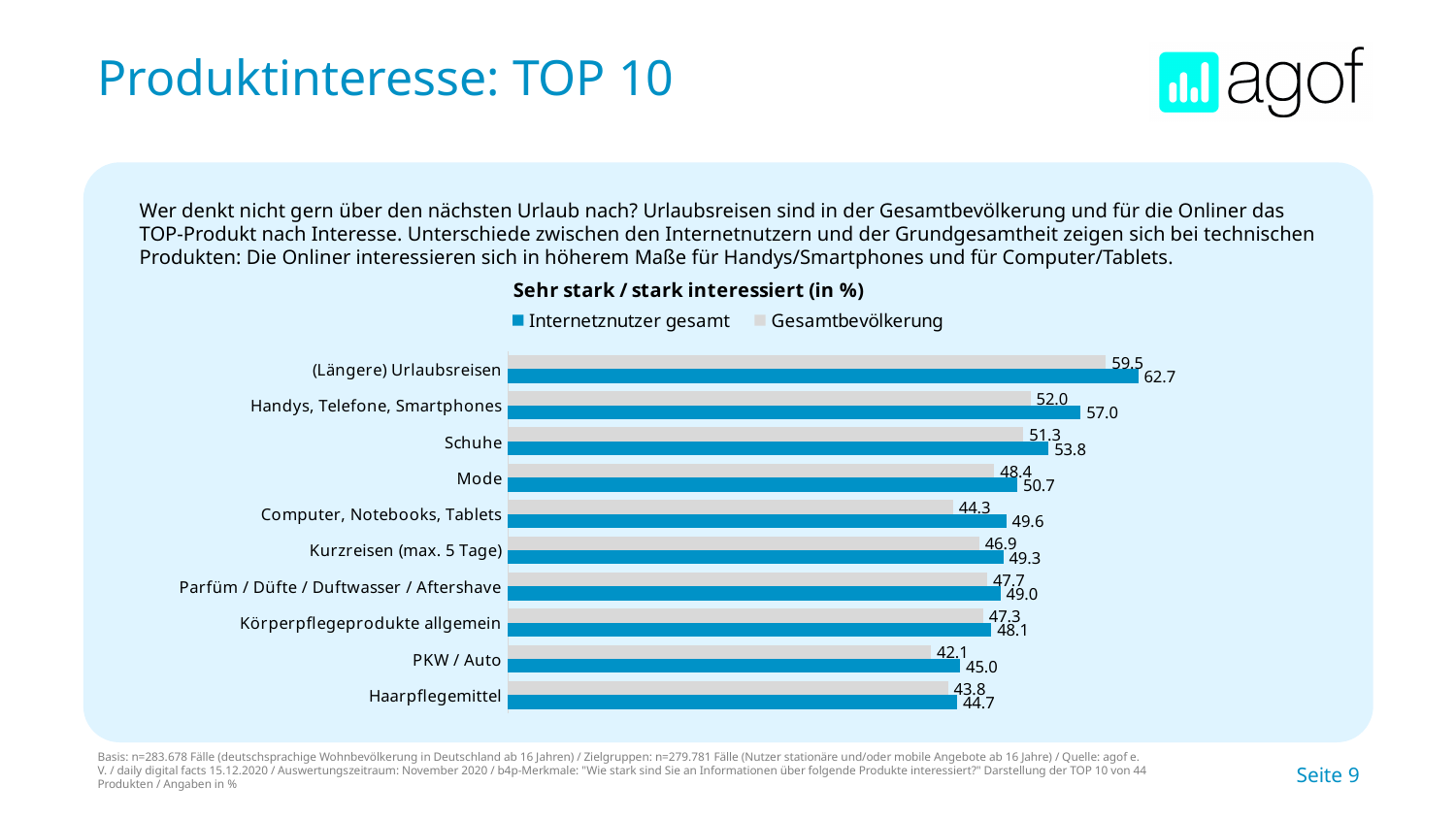
Which is larger for Schuhe: the value for Internetnutzer gesamt or for Gesamtbevölkerung? Internetnutzer gesamt What is the title of the chart? Sehr stark / stark interessiert (in %) How many series does the legend list? 2 How many product categories are shown in the chart? 10 What is the value for Gesamtbevölkerung for Handys, Telefone, Smartphones? 52.0 What is the value for Internetnutzer gesamt for (Längere) Urlaubsreisen? 62.7 What kind of chart is shown on the slide? Bar chart What is the difference between Internetnutzer gesamt and Gesamtbevölkerung for Handys, Telefone, Smartphones? 5.0 Which category has the highest value for Internetnutzer gesamt? (Längere) Urlaubsreisen What is the value for Internetnutzer gesamt for Computer, Notebooks, Tablets? 49.6 Which category has the lowest value for Gesamtbevölkerung? PKW / Auto What is the value for Gesamtbevölkerung for PKW / Auto? 42.1